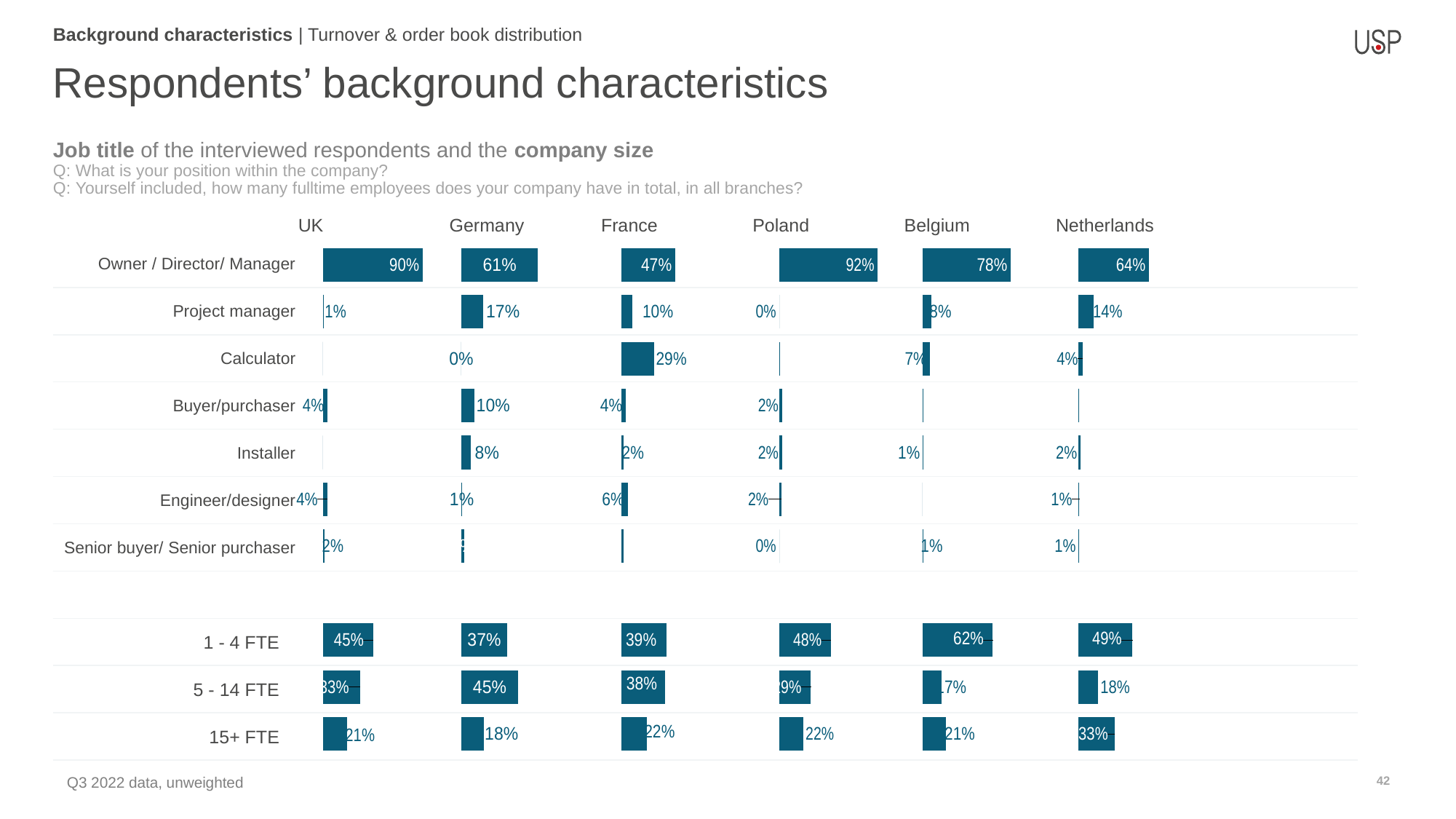
In the Belgium column, what share of companies have 1 - 4 FTE? 62% Which is larger: the 1 - 4 FTE share in the Germany column or in the France column? France In the Netherlands column, what share of companies have 15+ FTE? 33% How many job title categories are listed in the upper chart? 7 What type of chart is used to show the percentages on this slide? Bar chart Across the six country columns, which country has the lowest share of Owner / Director/ Manager respondents? France Across the six country columns, which country has the highest share of Owner / Director/ Manager respondents? Poland What is the difference between the Owner / Director/ Manager share in the UK column and in the Germany column? 29% In the Poland column, what percentage of respondents are Owner / Director/ Manager? 92% How many country columns are shown on the slide? 6 In the Germany column, what percentage of respondents are Project managers? 17% In the France column, what percentage of respondents are Calculators? 29%